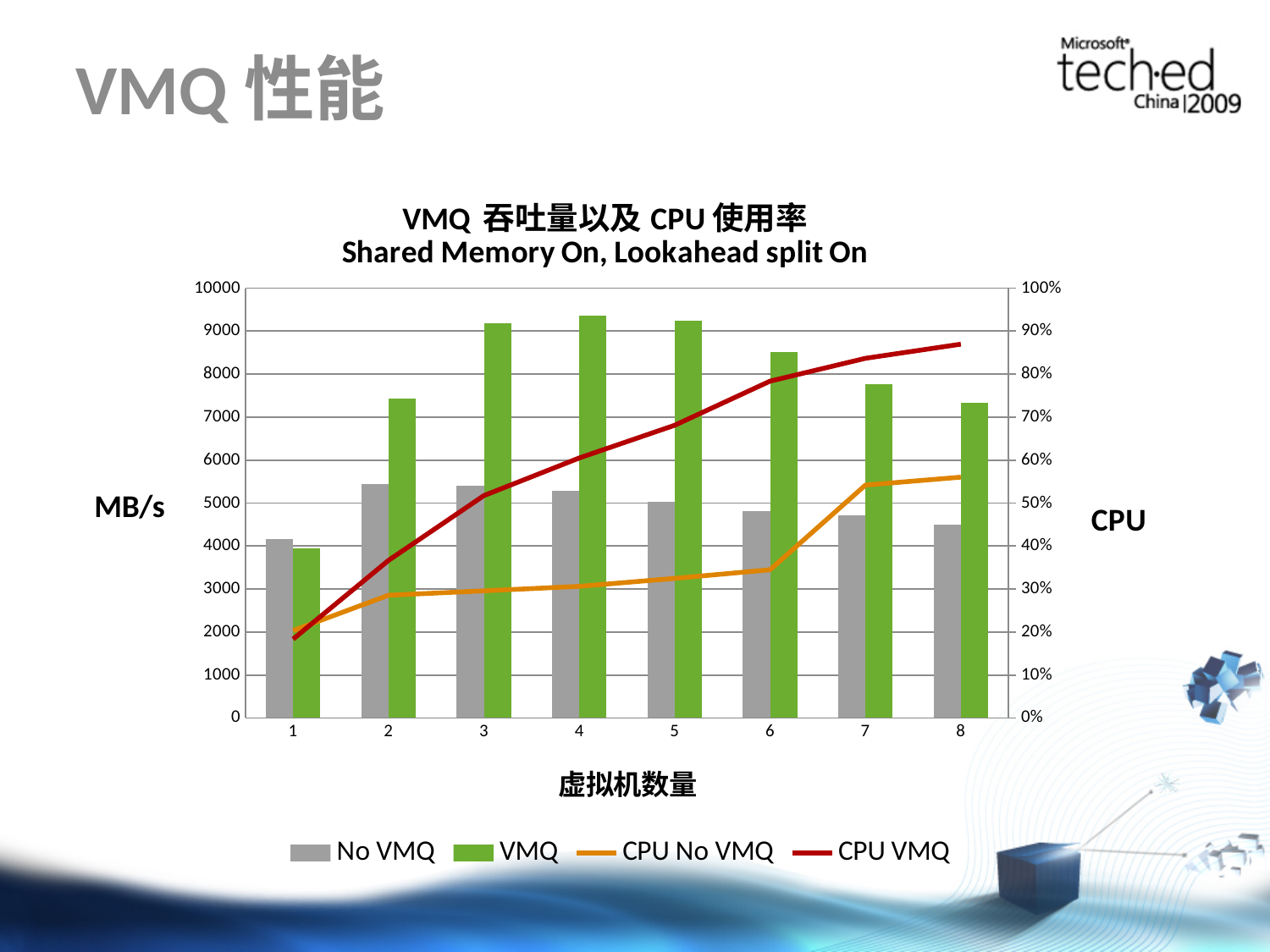
Is the CPU VMQ value at 8 virtual machines greater or less than 80%? greater How many series does the legend list? 4 Is the VMQ value at 2 virtual machines greater or less than 7000? greater At 2 virtual machines, which bar is taller: No VMQ or VMQ? VMQ Does the CPU VMQ line rise or fall as the number of virtual machines increases? rises Is the VMQ value at 4 virtual machines greater or less than 9000? greater At which number of virtual machines is the No VMQ bar lowest? 1 What kind of chart is shown on the slide? A combination bar and line chart How many virtual machine counts (categories) are shown on the x axis? 8 At which number of virtual machines is the VMQ bar lowest? 1